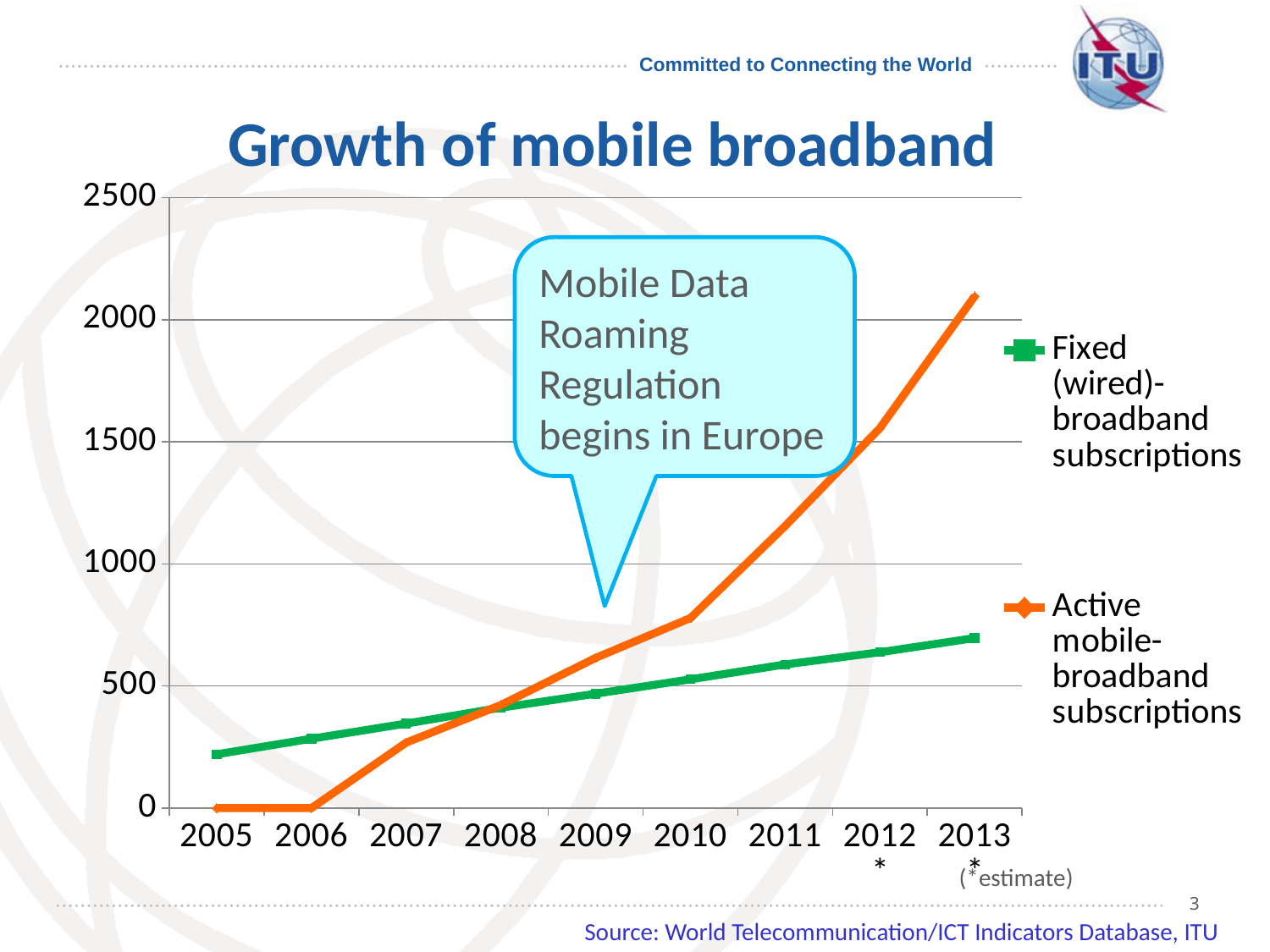
How many series does the legend list? 2 How many years are shown on the x axis? 9 Which series is drawn in orange? Active mobile-broadband subscriptions What is the title of the chart? Growth of mobile broadband Is the value for Active mobile-broadband subscriptions in 2011 greater or less than 1000? greater Is the value for Active mobile-broadband subscriptions in 2013 greater or less than 2000? greater Is the value for Fixed (wired)-broadband subscriptions in 2013 greater or less than 1000? less In 2013, which series has the higher value: Fixed (wired)-broadband subscriptions or Active mobile-broadband subscriptions? Active mobile-broadband subscriptions In 2006, which series has the higher value: Fixed (wired)-broadband subscriptions or Active mobile-broadband subscriptions? Fixed (wired)-broadband subscriptions Do Active mobile-broadband subscriptions rise or fall from 2007 to 2013? rise What kind of chart is shown on the slide? line chart Do Fixed (wired)-broadband subscriptions rise or fall from 2005 to 2013? rise